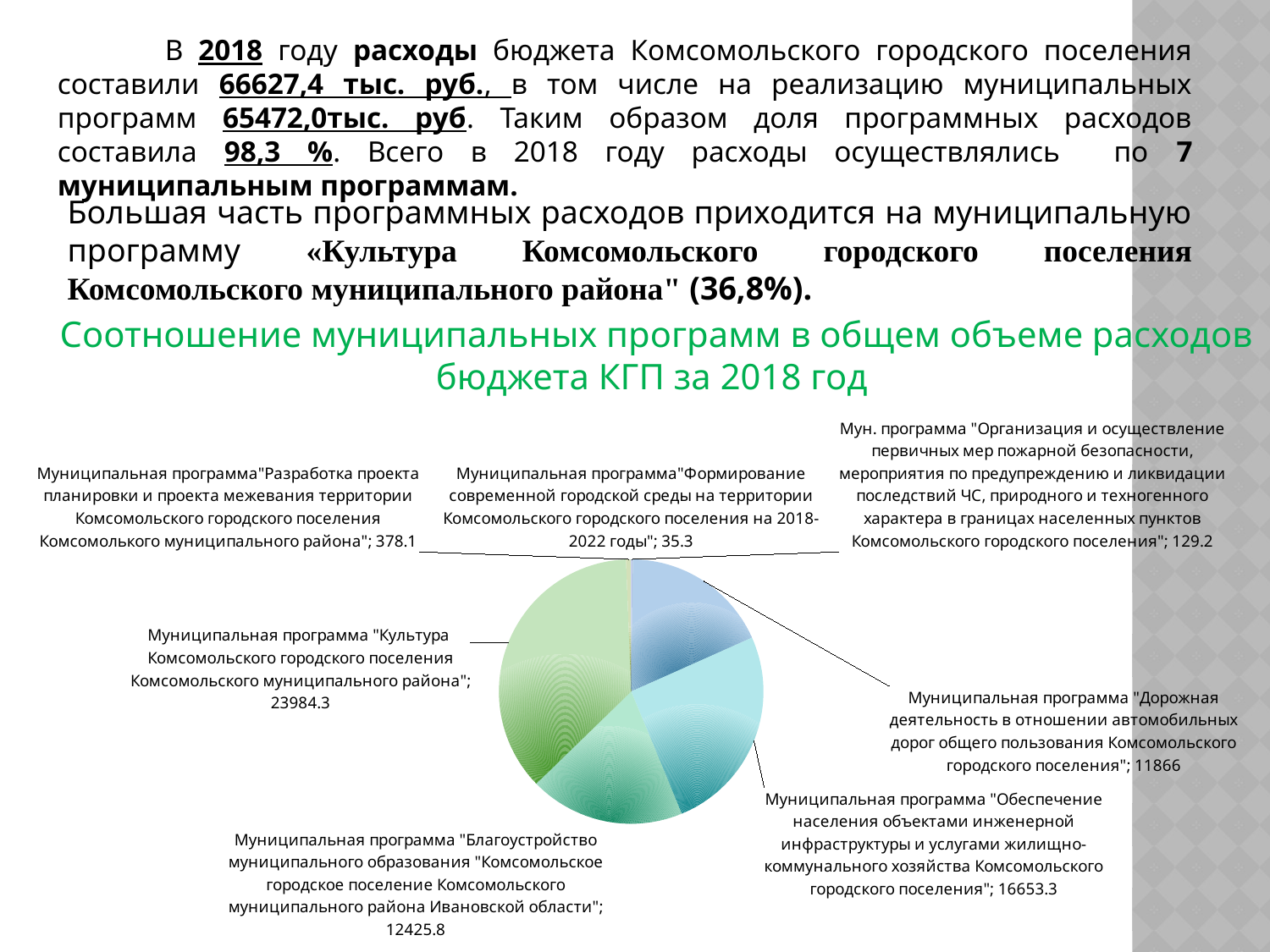
How many slices does the pie chart have? 7 What is the title of the chart? Соотношение муниципальных программ в общем объеме расходов бюджета КГП за 2018 год What is the value for the municipal program "Благоустройство муниципального образования"? 12425.8 What is the value for the municipal program "Формирование современной городской среды на территории Комсомольского городского поселения на 2018-2022 годы"? 35.3 Which municipal program has the smallest slice of the pie chart? Формирование современной городской среды на территории Комсомольского городского поселения на 2018-2022 годы Which municipal program has the largest slice of the pie chart? Культура Комсомольского городского поселения Комсомольского муниципального района What is the total of all the values shown in the pie chart? 65472.0 What is the difference between the value for "Обеспечение населения объектами инженерной инфраструктуры" (16653.3) and "Дорожная деятельность" (11866)? 4787.3 What is the value for the municipal program "Дорожная деятельность в отношении автомобильных дорог общего пользования Комсомольского городского поселения"? 11866 What kind of chart is shown on the slide? pie chart What is the value for the municipal program "Культура Комсомольского городского поселения Комсомольского муниципального района"? 23984.3 Which is larger: the value for "Разработка проекта планировки и проекта межевания территории" or the value for "Организация и осуществление первичных мер пожарной безопасности"? Разработка проекта планировки и проекта межевания территории